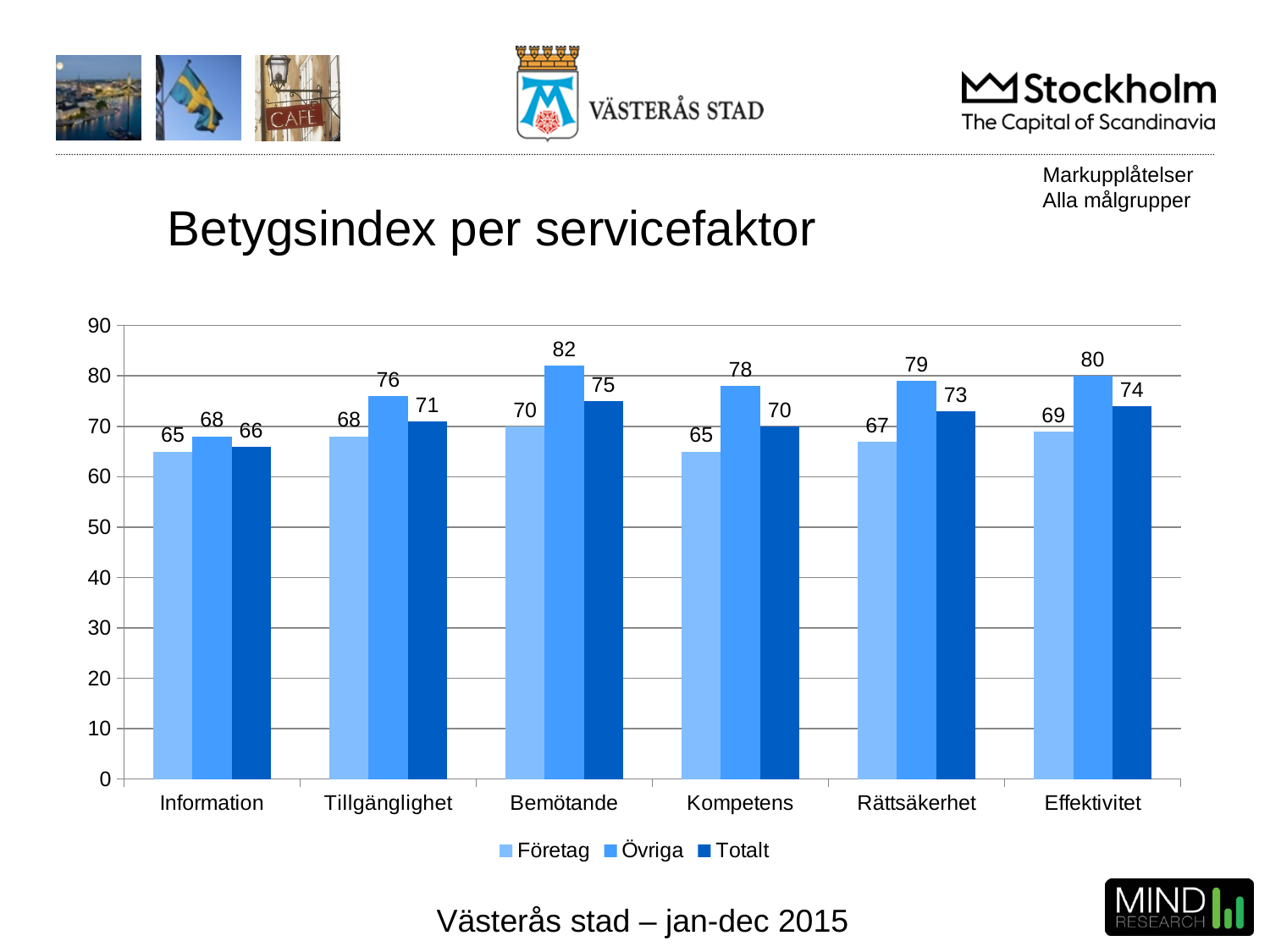
How many service factors are shown on the x axis? 6 What is the Företag value for Rättsäkerhet? 67 How many series does the legend list? 3 What is the Övriga value for Effektivitet? 80 What kind of chart is shown on the slide? bar chart What is the Totalt value for Bemötande? 75 What is the difference between the Övriga and Företag values for Kompetens? 13 Which service factor has the lowest Totalt value? Information Is the Övriga value for Rättsäkerhet greater or less than 70? greater Which service factor has the highest Övriga value? Bemötande What is the title of the chart? Betygsindex per servicefaktor Which is larger for Tillgänglighet: the Företag value or the Totalt value? Totalt